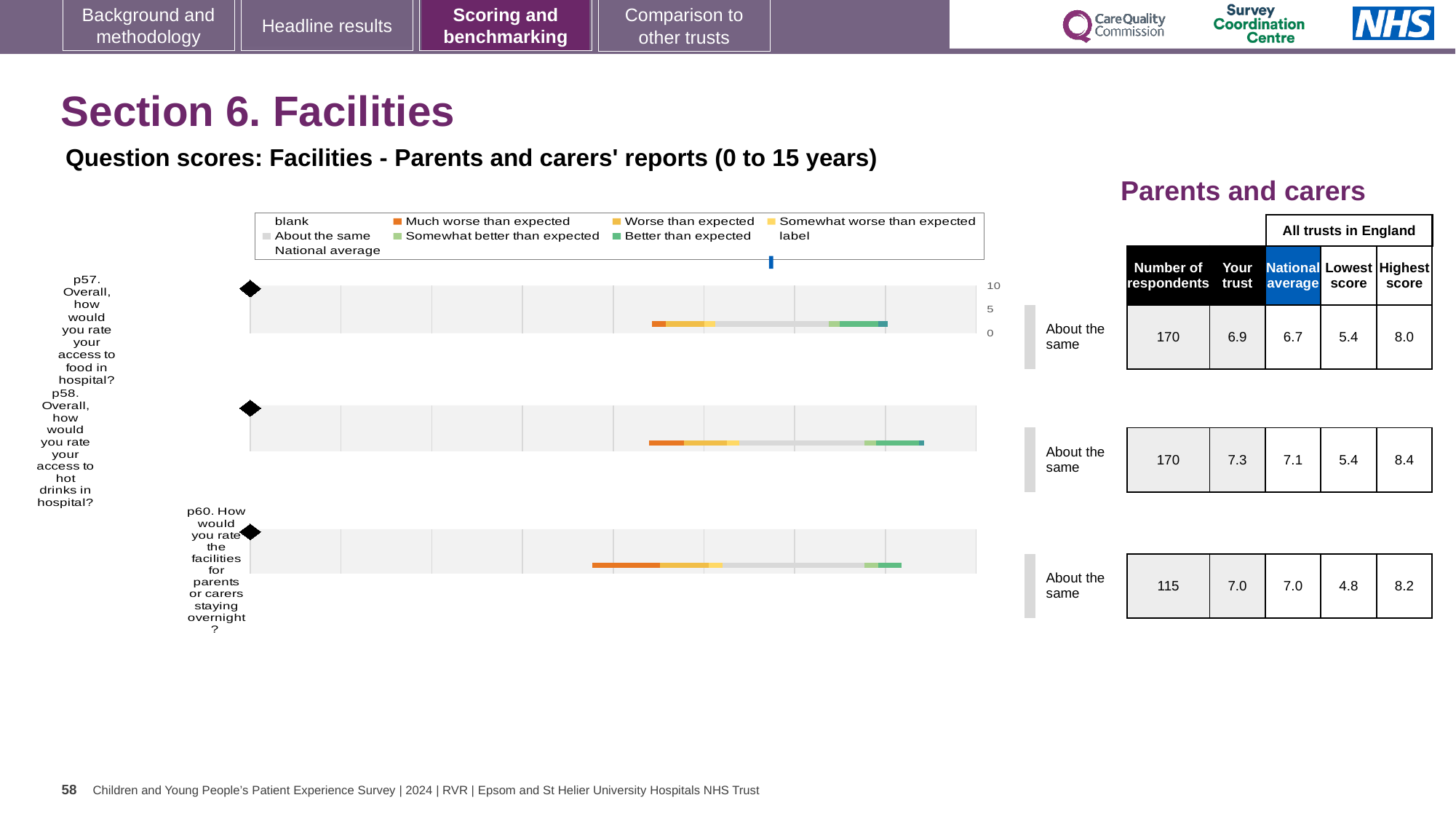
What is the difference between the highest and lowest scores across all trusts in England for p60? 3.4 What is the difference between the 'Your trust' score and the national average for p58? 0.2 What is the highest score among all trusts in England for p58? 8.4 What is the benchmark category shown for p57? About the same How many respondents answered p60 (facilities for parents or carers staying overnight)? 115 What is the national average score for p58 (access to hot drinks in hospital)? 7.1 How many questions (categories) are plotted on the chart? 3 What is the 'Your trust' score for p57 (access to food in hospital)? 6.9 Which question has the lowest 'Lowest score' across all trusts in England? p60 What is the maximum value shown on the chart's score axis? 10 For p58, is the 'Your trust' score or the national average larger? Your trust Which question has the highest 'Your trust' score? p58